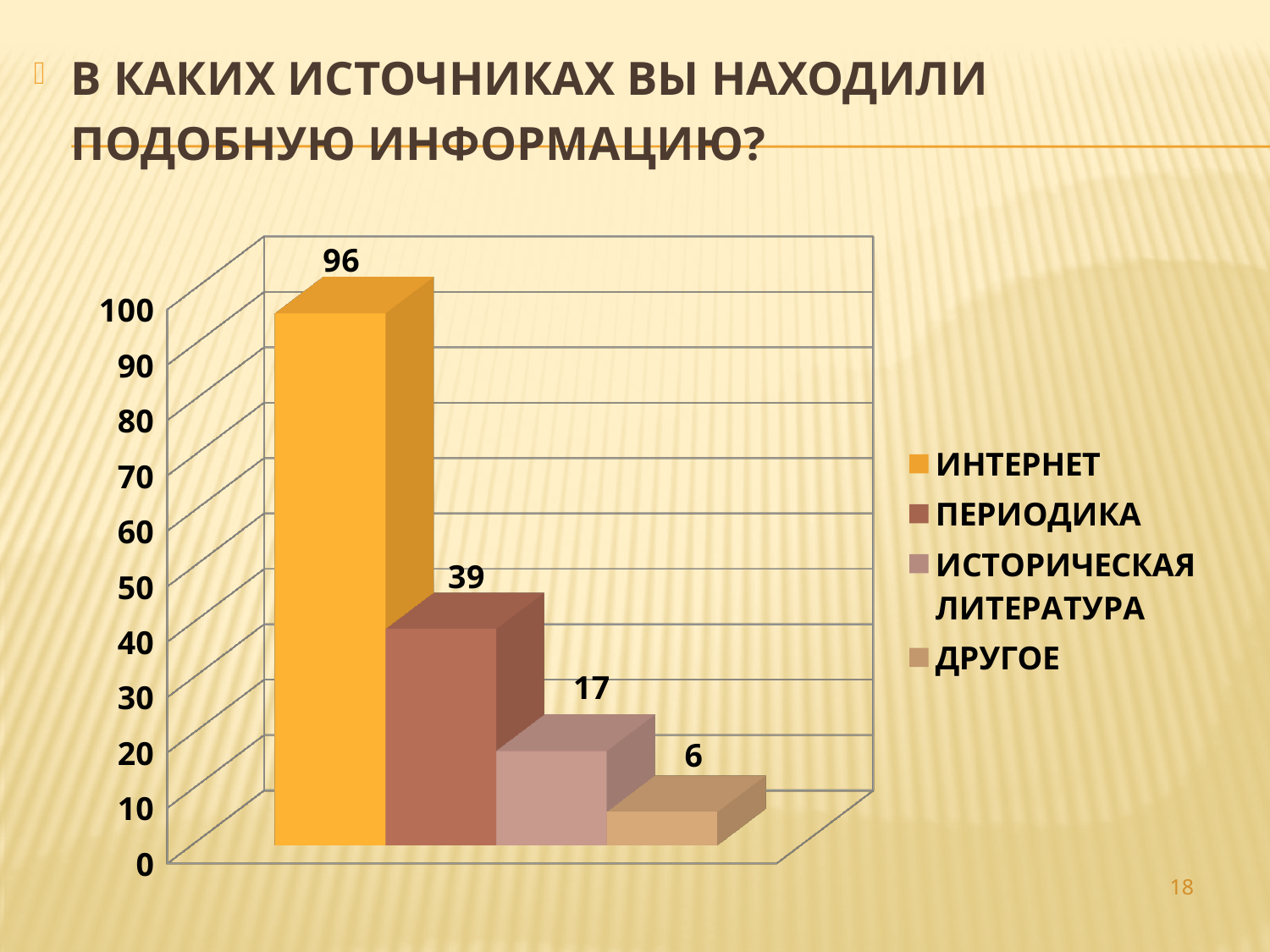
What colour is the bar for ИНТЕРНЕТ? orange How many series does the legend list? 4 Which source has the lowest value? ДРУГОЕ What is the difference between the values for ИНТЕРНЕТ and ПЕРИОДИКА? 57 What is the value for ПЕРИОДИКА? 39 Is the value for ИНТЕРНЕТ greater or less than 50? greater Which source has the highest value? ИНТЕРНЕТ What kind of chart is shown on the slide? bar chart What is the value for ДРУГОЕ? 6 What is the value for ИСТОРИЧЕСКАЯ ЛИТЕРАТУРА? 17 Which is larger, the value for ПЕРИОДИКА or the value for ИСТОРИЧЕСКАЯ ЛИТЕРАТУРА? ПЕРИОДИКА What is the value for ИНТЕРНЕТ? 96